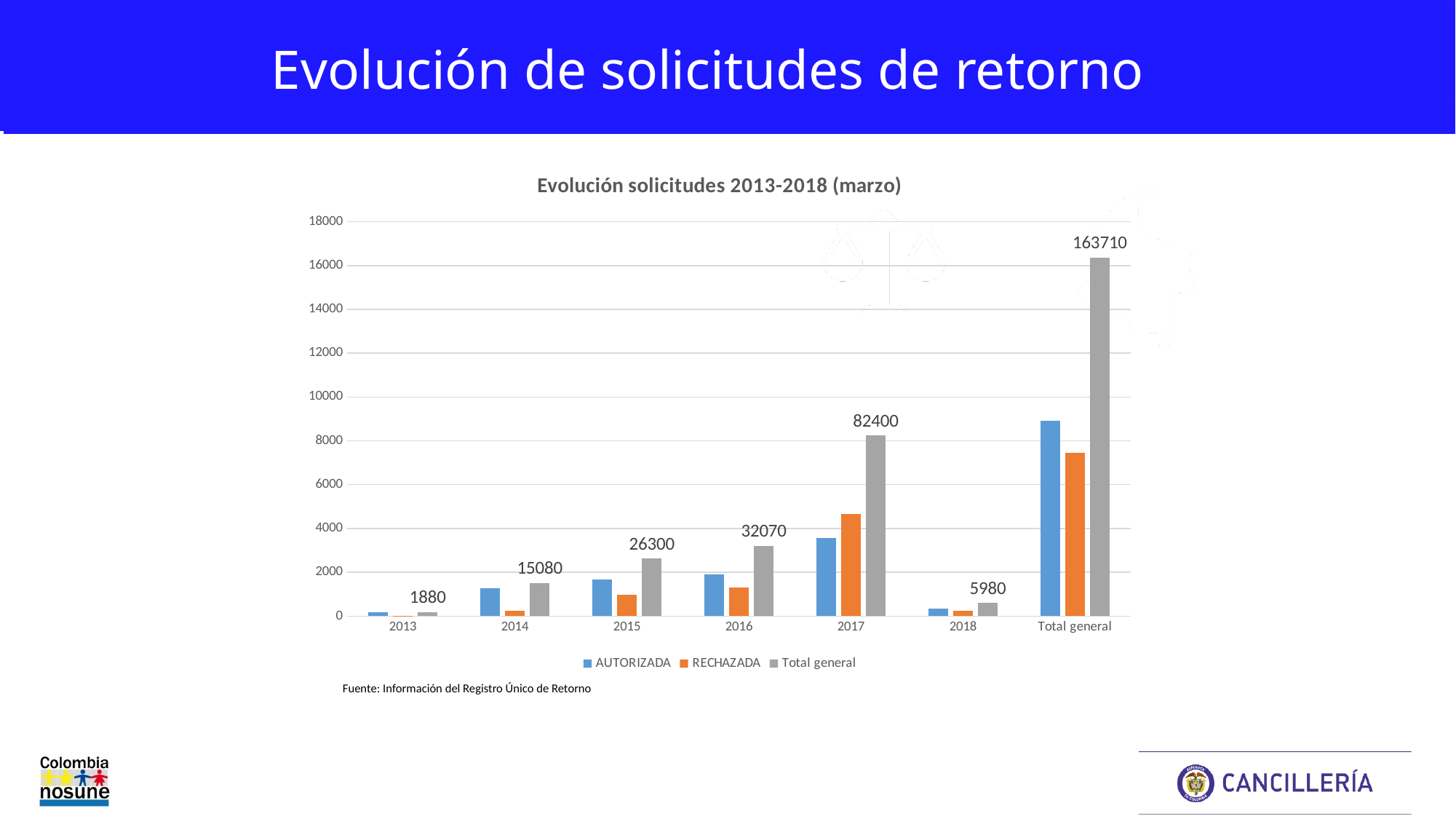
Among the years 2013 to 2018, which year has the highest Total general label? 2017 Which is larger, the Total general label for 2015 or for 2018? 2015 What is the data label shown for Total general in 2013? 1880 What is the data label shown for Total general in 2017? 82400 What is the data label shown for the Total general category at the far right of the chart? 163710 How many series does the legend list? 3 How many categories are shown on the x axis? 7 Is the value for RECHAZADA in 2017 greater or less than 4000? greater Among the years 2013 to 2018, which year has the lowest Total general label? 2013 What is the difference between the Total general labels for 2017 and 2016? 50330 Is the value for AUTORIZADA in the Total general category greater or less than 8000? greater What kind of chart is shown on the slide? Bar chart